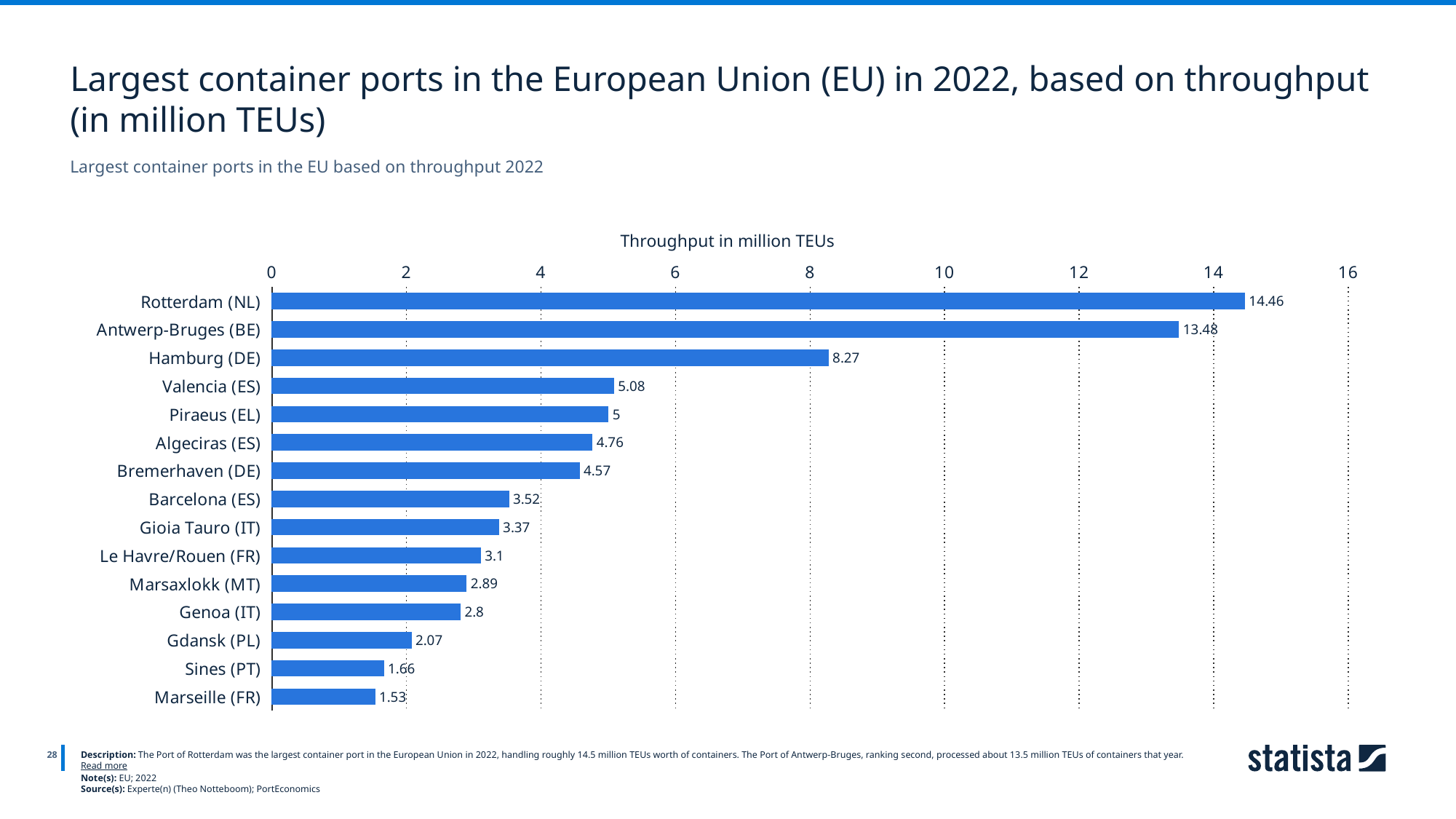
Which port has a larger throughput, Valencia (ES) or Algeciras (ES)? Valencia (ES) What is the throughput of Gioia Tauro (IT) in million TEUs? 3.37 How many ports are shown in the chart? 15 Is the value for Bremerhaven (DE) greater or less than 4? greater What is the throughput of Sines (PT) in million TEUs? 1.66 What is the axis title shown above the chart? Throughput in million TEUs Which port has the lowest throughput? Marseille (FR) What kind of chart is shown on the slide? Bar chart Which port has the highest throughput? Rotterdam (NL) What is the throughput of Hamburg (DE) in million TEUs? 8.27 What is the difference in throughput between Hamburg (DE) and Valencia (ES), in million TEUs? 3.19 What is the difference in throughput between Rotterdam (NL) and Antwerp-Bruges (BE), in million TEUs? 0.98